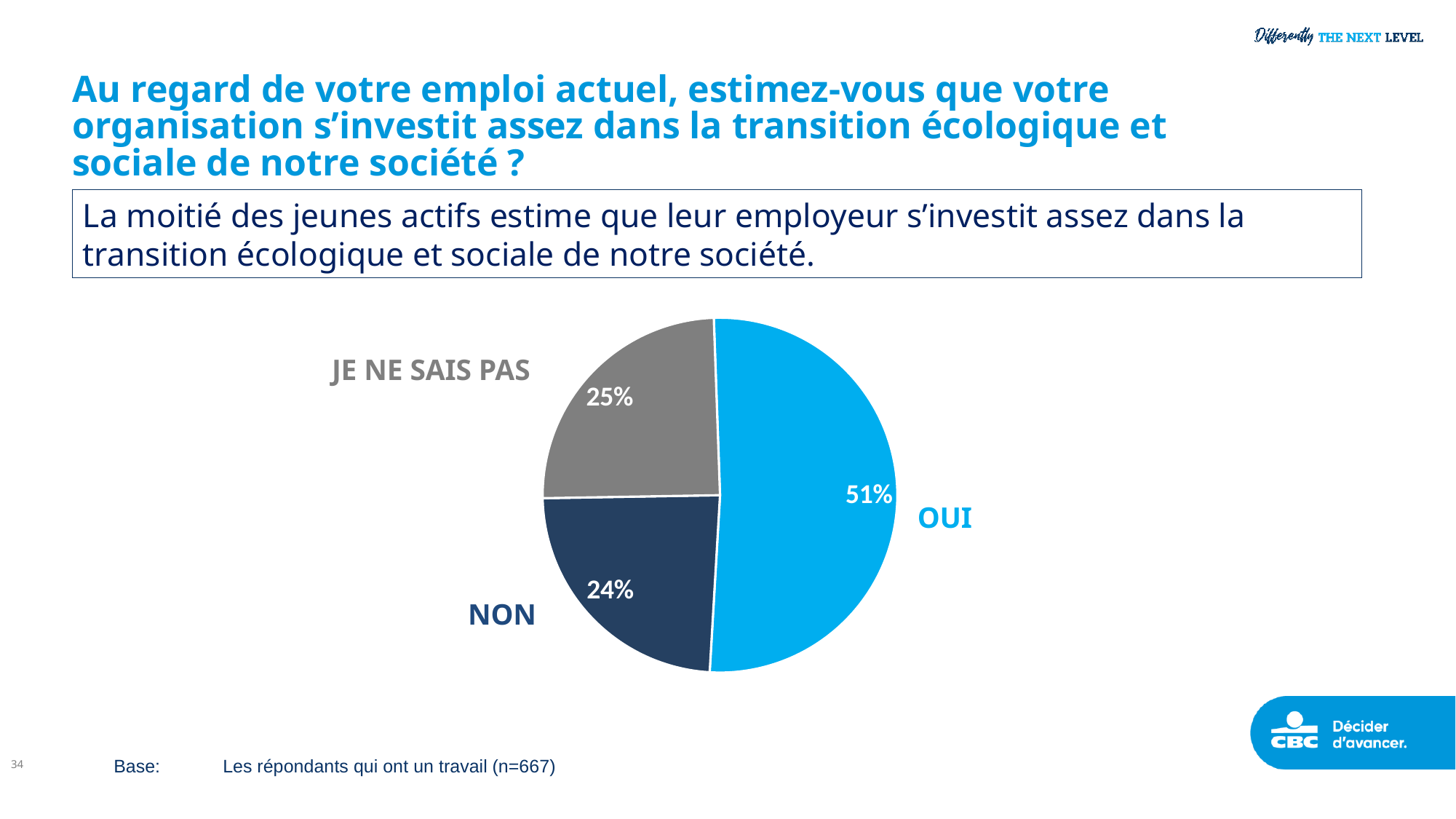
What is the difference in percentage points between OUI and NON? 27 What percentage of respondents answered OUI? 51% What is the base (number of respondents) stated for the chart? n=667 How many slices does the pie chart have? 3 Which response has the largest share of the pie? OUI What percentage of respondents answered NON? 24% What percentage of respondents answered JE NE SAIS PAS? 25% Which is larger, the share for OUI or the share for JE NE SAIS PAS? OUI What is the difference in percentage points between JE NE SAIS PAS and NON? 1 What colour is the OUI slice of the pie chart? Light blue Which response has the smallest share of the pie? NON What kind of chart is shown on the slide? Pie chart